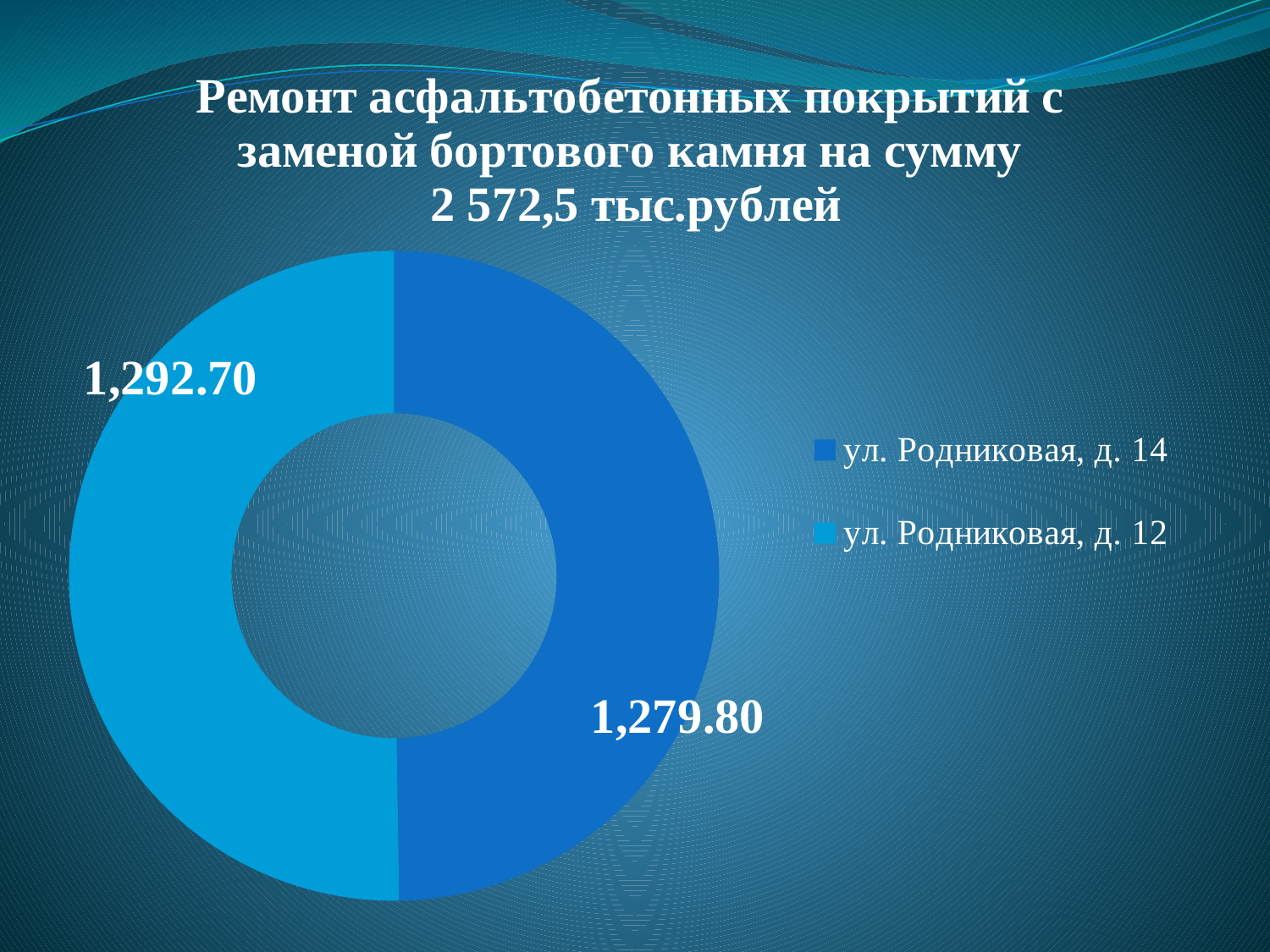
Which category has the smaller value? ул. Родниковая, д. 14 What is the value for ул. Родниковая, д. 12? 1,292.70 What is the value for ул. Родниковая, д. 14? 1,279.80 What is the total of the two values shown on the chart? 2,572.50 What is the difference between the values for ул. Родниковая, д. 12 and ул. Родниковая, д. 14? 12.90 Is the value for ул. Родниковая, д. 14 larger or smaller than the value for ул. Родниковая, д. 12? smaller How many categories does the chart show? 2 What total sum is stated in the slide title? 2 572,5 тыс.рублей Which category has the larger value? ул. Родниковая, д. 12 How many entries does the legend list? 2 What kind of chart is shown on the slide? doughnut chart Which legend entry is shown in the lighter blue colour? ул. Родниковая, д. 12